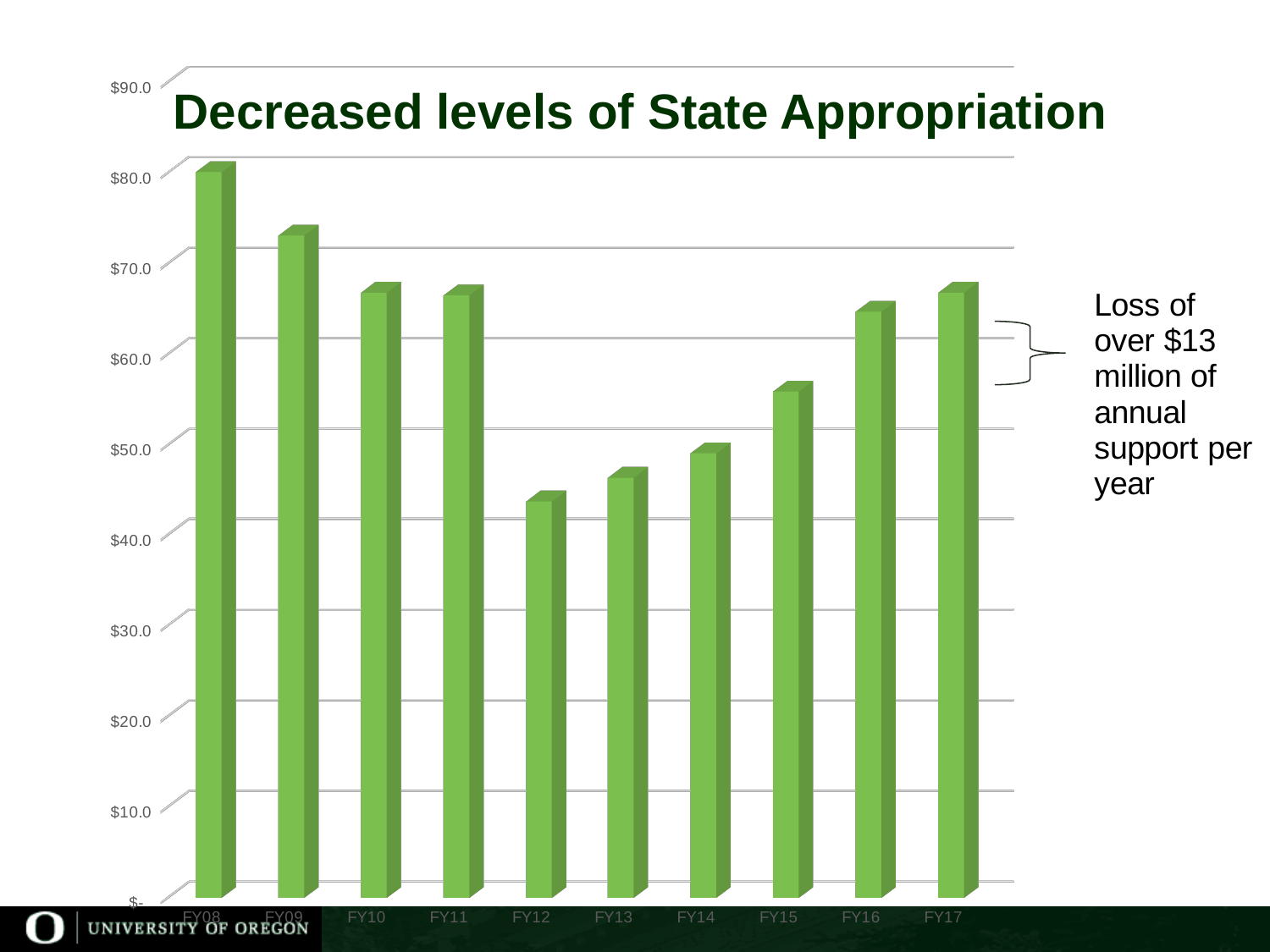
Which is larger, the value for FY08 or the value for FY17? FY08 Is the value for FY12 greater or less than $50.0? less Do the values rise or fall from FY08 to FY12? fall How many fiscal years are plotted in the chart? 10 What kind of chart is shown on the slide? Bar chart Which fiscal year has the highest value? FY08 Do the values rise or fall from FY12 to FY17? rise What is the title of the chart? Decreased levels of State Appropriation Which fiscal year has the lowest value? FY12 Is the value for FY16 greater or less than $60.0? greater Is the value for FY08 greater or less than $70.0? greater